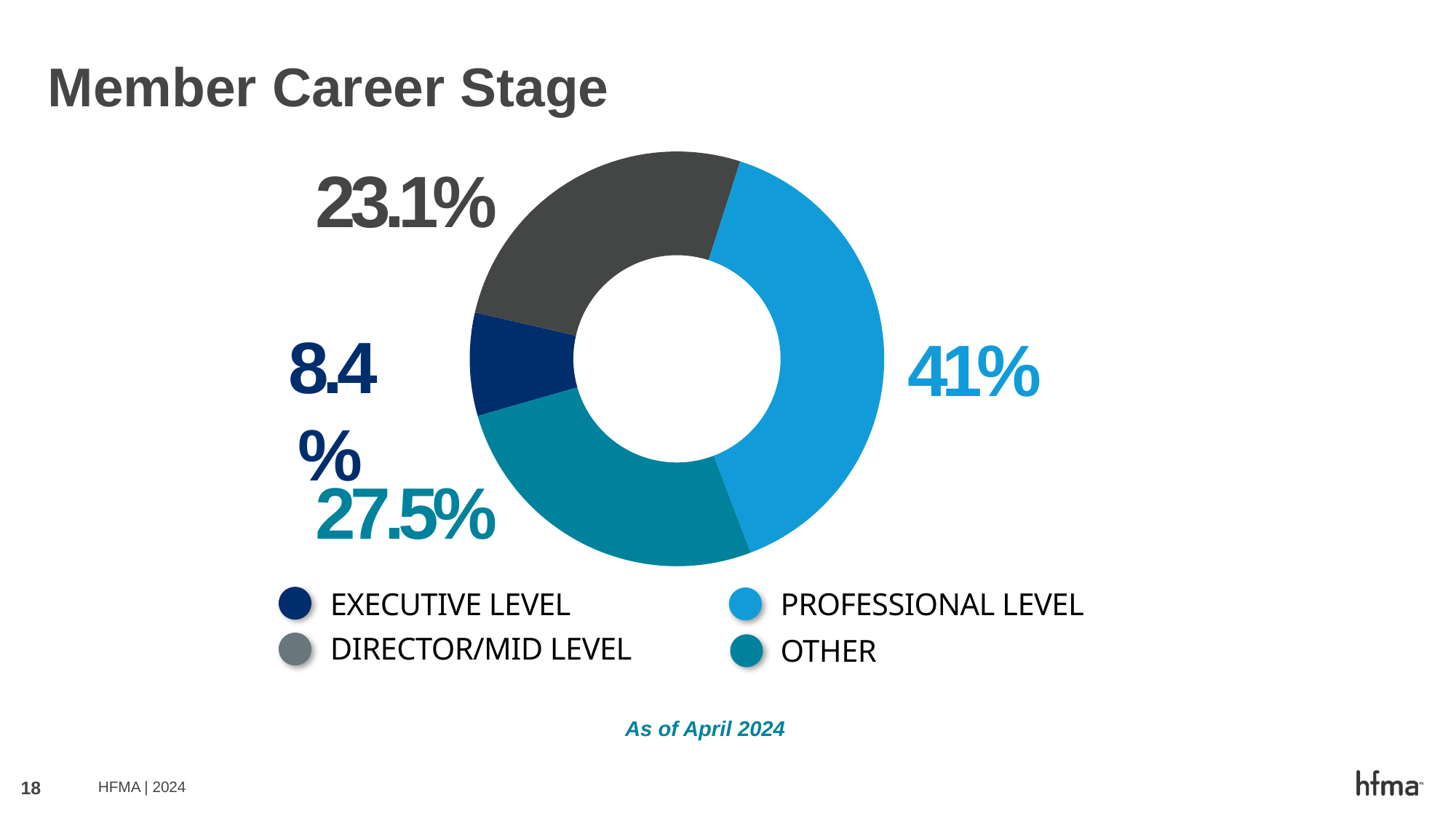
What percentage of members are at the Director/Mid Level? 23.1% Which career stage has the largest share of members? Professional Level What percentage of members are at the Executive Level? 8.4% Which career stage has the smallest share of members? Executive Level As of what date is the chart data reported? April 2024 Which is larger, the Other share or the Director/Mid Level share? Other What percentage of members are at the Professional Level? 41% What percentage of members fall into the Other category? 27.5% What is the difference in percentage points between the Professional Level and Director/Mid Level shares? 17.9 What is the title of the chart on this slide? Member Career Stage How many career stage categories are shown in the chart? 4 What kind of chart is used on this slide? Pie chart (donut)